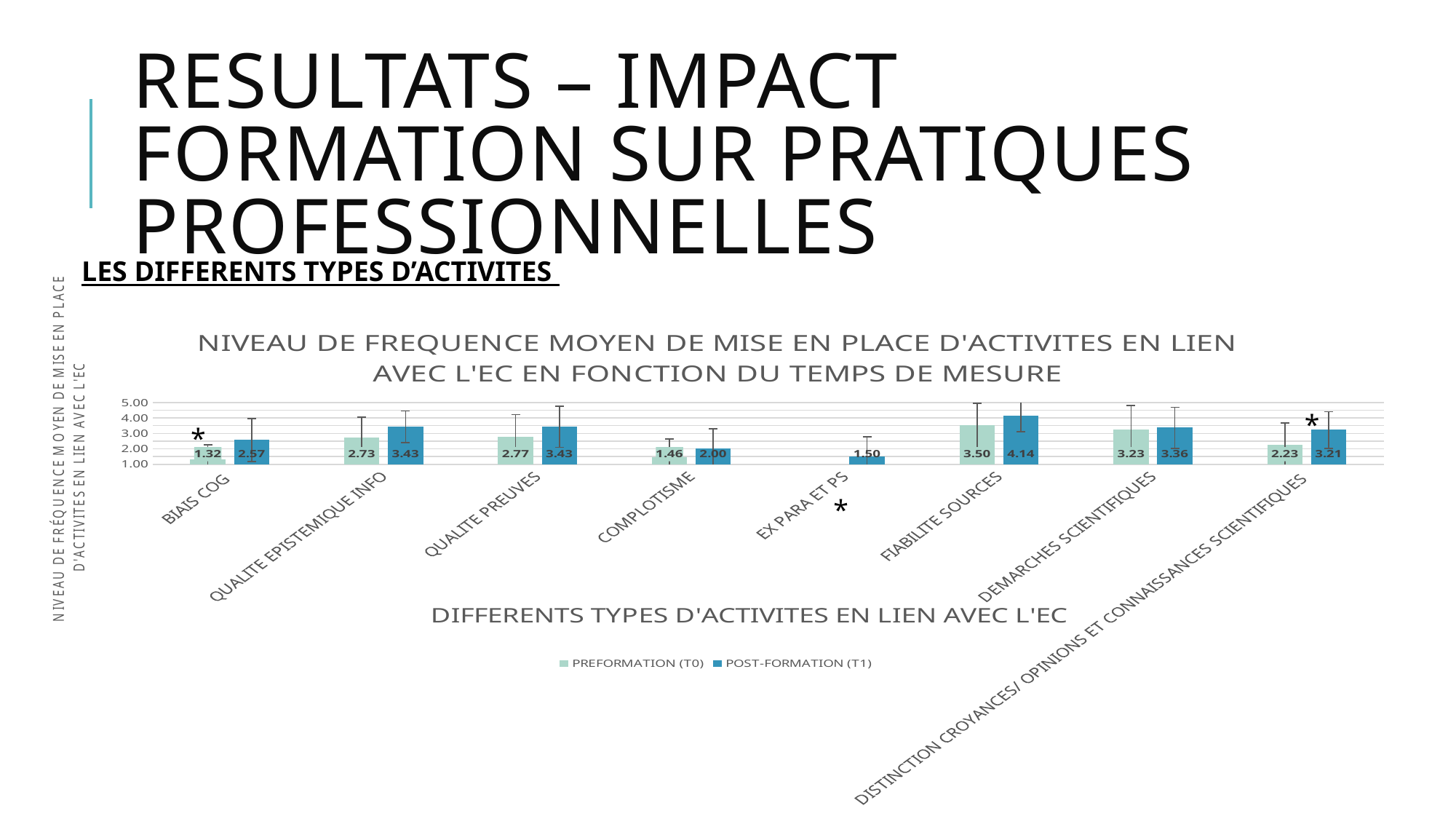
What is the PREFORMATION (T0) value for BIAIS COG? 1.32 How many series does the legend list? 2 Which activity type has the lowest POST-FORMATION (T1) value? EX PARA ET PS Which activity type has the highest POST-FORMATION (T1) value? FIABILITE SOURCES What is the POST-FORMATION (T1) value for FIABILITE SOURCES? 4.14 What kind of chart is shown on the slide? Bar chart Which is larger: the POST-FORMATION (T1) value for BIAIS COG or the POST-FORMATION (T1) value for COMPLOTISME? BIAIS COG What is the difference between the POST-FORMATION (T1) and PREFORMATION (T0) values for BIAIS COG? 1.25 Which activity type has the highest PREFORMATION (T0) value? FIABILITE SOURCES What is the PREFORMATION (T0) value for COMPLOTISME? 1.46 How many activity types are shown on the x axis? 8 What is the POST-FORMATION (T1) value for DISTINCTION CROYANCES/ OPINIONS ET CONNAISSANCES SCIENTIFIQUES? 3.21